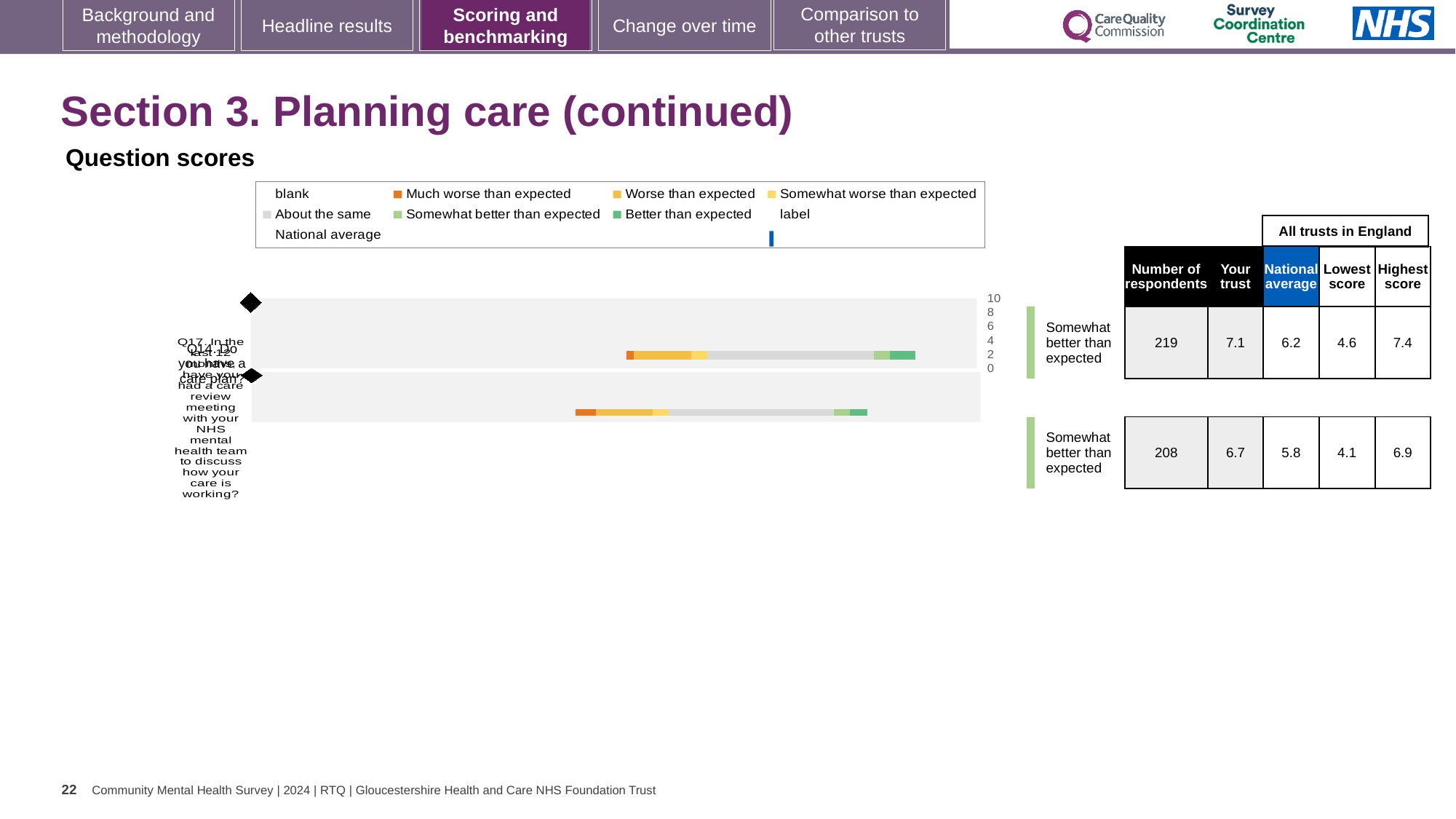
What is the national average for the second row (Q17) in the table beside the chart? 5.8 Which row has more respondents, the top row (Q14) or the second row (Q17)? Top row (Q14) What benchmark category is shown next to both question bars? Somewhat better than expected For the second row (Q17), how much higher is the 'Your trust' score than the national average? 0.9 How many question bars are plotted in the chart? 2 What is the lowest score among all trusts in England for the second row (Q17)? 4.1 What is the 'Your trust' score for the top row (Q14) in the table beside the chart? 7.1 For the top row (Q14), what is the difference between the highest score and the lowest score among all trusts in England? 2.8 What kind of chart is shown under 'Question scores'? bar chart For the top row (Q14), which is larger: the 'Your trust' score or the national average? Your trust What colour does the legend use for 'Much worse than expected'? Orange In the table beside the chart, what is the number of respondents for the top row (Q14)? 219